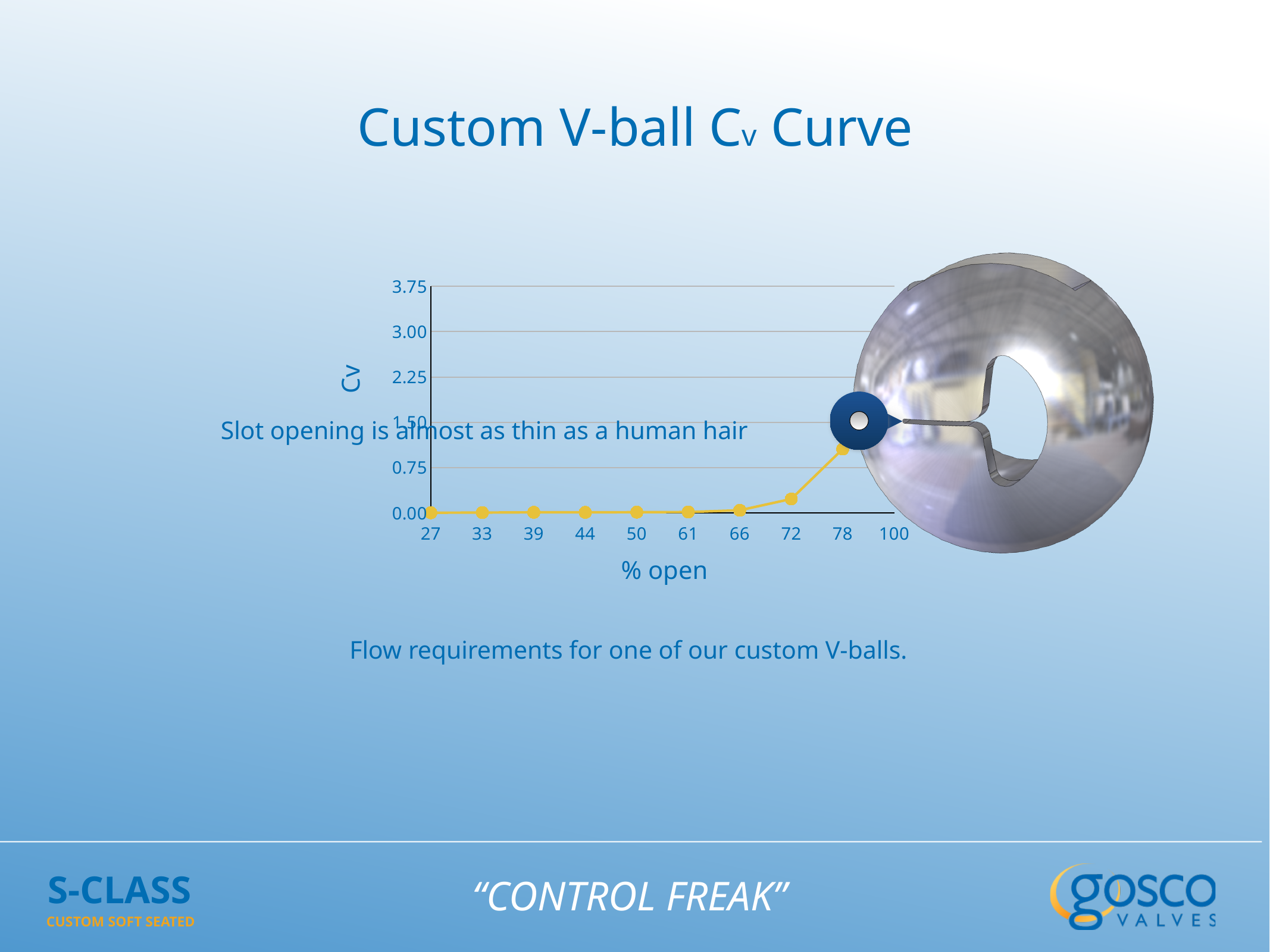
How many % open values are labelled on the x axis? 10 Which has the larger Cv value, 33% open or 78% open? 78% open What is the title of the chart? Custom V-ball Cv Curve What kind of chart is shown on the slide? line chart Is the Cv value at 78% open greater or less than 1.50? less What is the label of the x axis? % open Is the Cv value at 78% open greater or less than 0.75? greater Does the Cv value rise or fall as % open increases from 66 to 78? rise Is the Cv value at 72% open greater or less than 0.75? less Which has the larger Cv value, 72% open or 78% open? 78% open